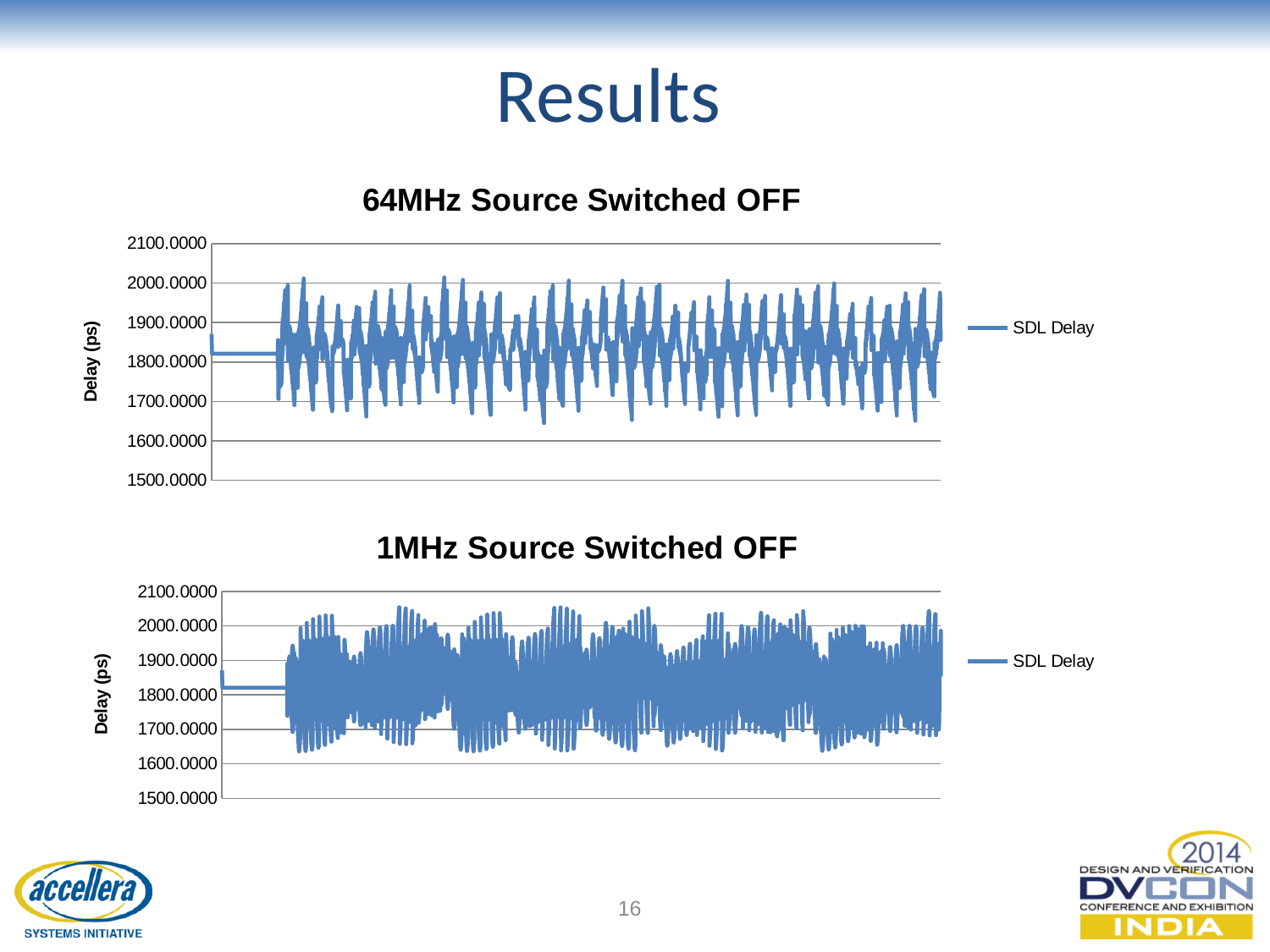
In the "1MHz Source Switched OFF" chart, is the flat initial value of SDL Delay before the oscillation begins greater or less than 1900.0000? less What kind of chart is the "1MHz Source Switched OFF" chart? line chart In the "64MHz Source Switched OFF" chart, is the flat initial value of SDL Delay before the oscillation begins greater or less than 1900.0000? less How many series does the legend of the "64MHz Source Switched OFF" chart list? 1 In the "64MHz Source Switched OFF" chart, is the flat initial value of SDL Delay before the oscillation begins greater or less than 1700.0000? greater What is the name of the series plotted in the "64MHz Source Switched OFF" chart? SDL Delay How many series does the legend of the "1MHz Source Switched OFF" chart list? 1 What kind of chart is the "64MHz Source Switched OFF" chart? line chart What is the y-axis label of the "1MHz Source Switched OFF" chart? Delay (ps)